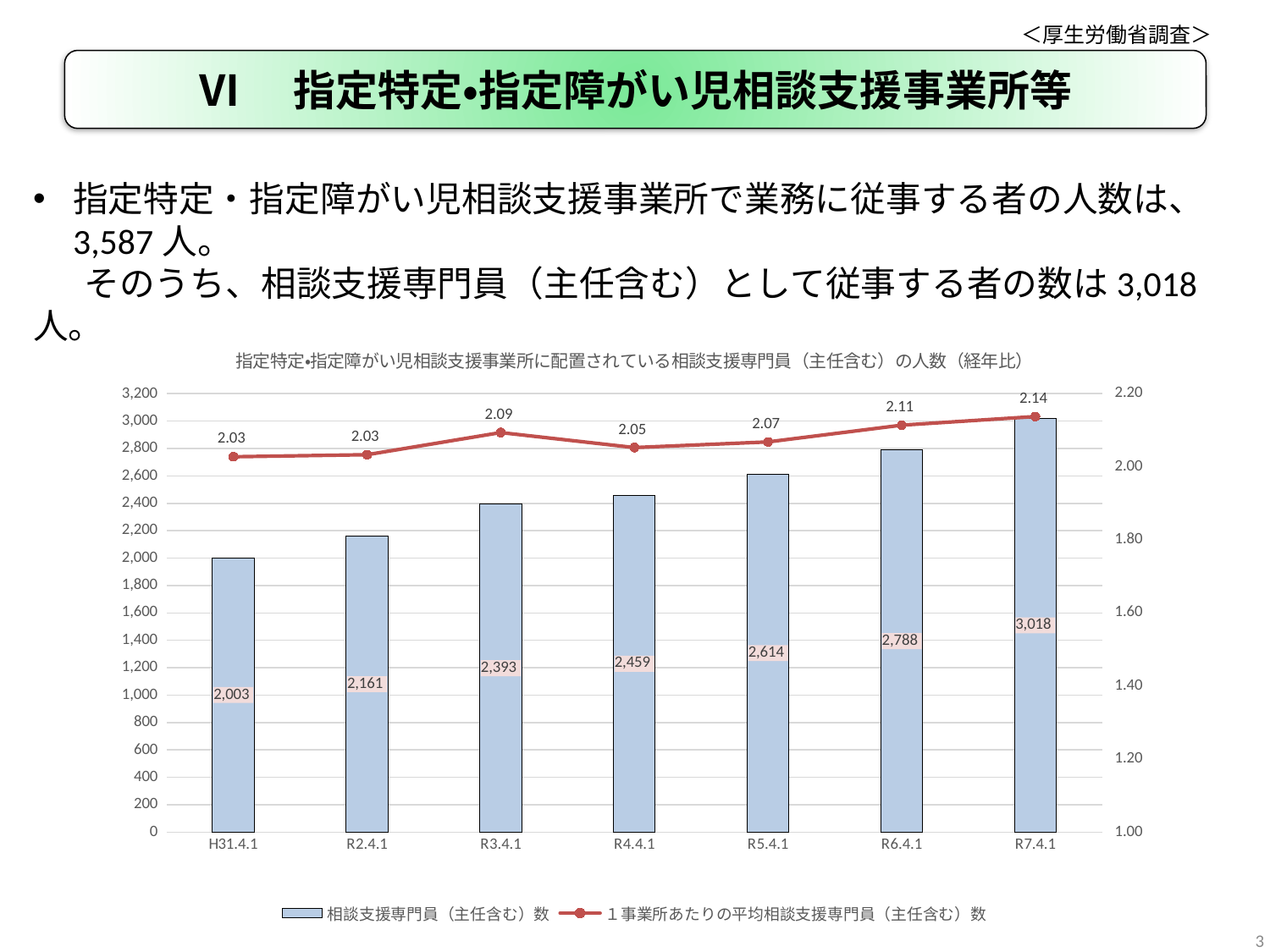
相談支援専門員（主任含む）数が最も多い時点はどれですか？ R7.4.1 グラフには何時点のデータが示されていますか？ 7 1事業所あたりの平均相談支援専門員（主任含む）数が最も高い時点はどれですか？ R7.4.1 相談支援専門員（主任含む）数はH31.4.1からR7.4.1にかけて増加していますか、減少していますか？ 増加 R3.4.1とR4.4.1では、1事業所あたりの平均相談支援専門員（主任含む）数はどちらが大きいですか？ R3.4.1 R4.4.1の相談支援専門員（主任含む）数はいくつですか？ 2,459 このグラフはどのような種類のグラフですか？ 棒グラフと折れ線グラフの複合グラフ R7.4.1とH31.4.1の相談支援専門員（主任含む）数の差はいくつですか？ 1,015 H31.4.1の1事業所あたりの平均相談支援専門員（主任含む）数はいくつですか？ 2.03 相談支援専門員（主任含む）数が最も少ない時点はどれですか？ H31.4.1 R7.4.1の相談支援専門員（主任含む）数はいくつですか？ 3,018 凡例には何系列が示されていますか？ 2